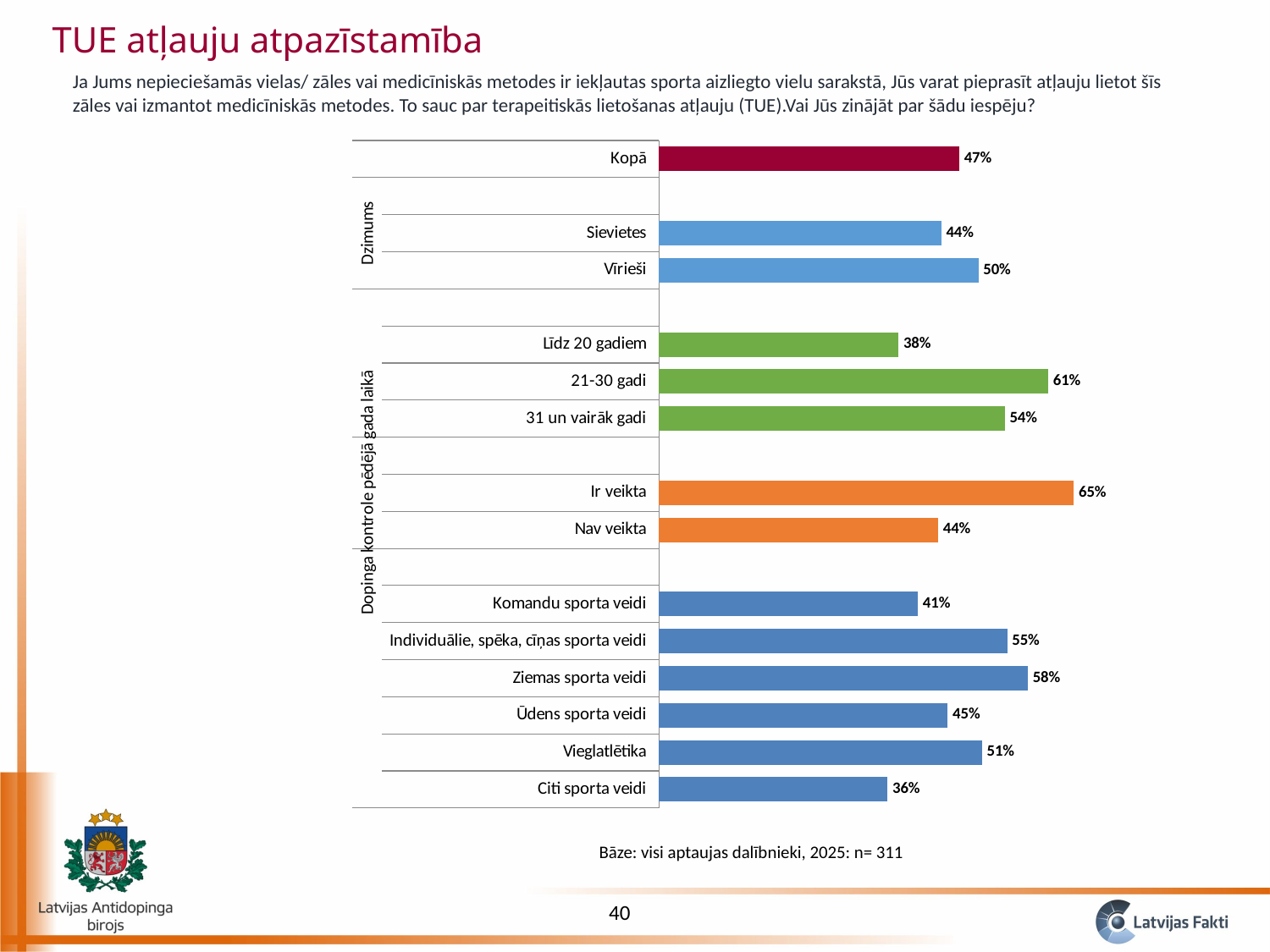
Which category has the highest value? Ir veikta What is the value for Sievietes? 44% What is the base (n) stated below the chart? n= 311 How many bars are plotted on the chart? 14 Which is larger, the value for Vīrieši or the value for Sievietes? Vīrieši What is the difference between the values for Ir veikta and Nav veikta? 21% What is the value for Kopā? 47% Which category has the lowest value? Citi sporta veidi What is the difference between the values for Vīrieši and Līdz 20 gadiem? 12% What kind of chart is shown on the slide? Bar chart What is the value for Ziemas sporta veidi? 58% What is the value for 21-30 gadi? 61%